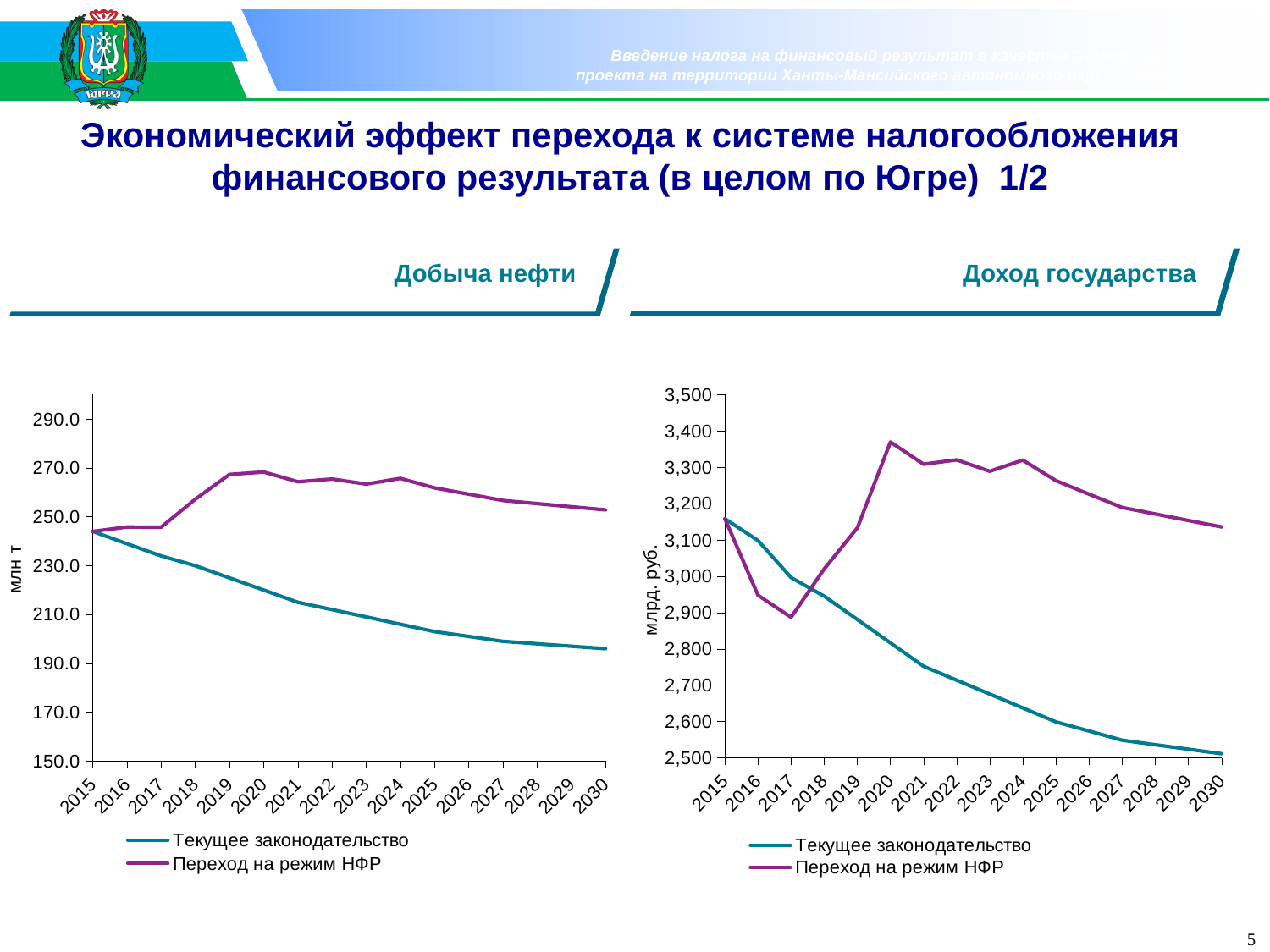
What unit is shown on the y axis of the "Доход государства" chart? млрд. руб. In the "Добыча нефти" chart, is the value for "Переход на режим НФР" in 2020 greater or less than 250.0? greater In the "Доход государства" chart, which series has the higher value in 2016? Текущее законодательство In the "Доход государства" chart, is the value for "Текущее законодательство" in 2030 greater or less than 2,600? less How many series does the legend of the "Доход государства" chart list? 2 How many years are plotted along the x axis of the "Добыча нефти" chart? 16 In the "Доход государства" chart, is the value for "Переход на режим НФР" in 2020 greater or less than 3,300? greater In the "Доход государства" chart, in which year does the "Переход на режим НФР" line reach its highest value? 2020 In the "Добыча нефти" chart, does the "Текущее законодательство" line rise or fall from 2015 to 2030? fall In the "Доход государства" chart, does the "Текущее законодательство" line rise or fall from 2015 to 2030? fall What kind of chart is the "Добыча нефти" chart? line chart